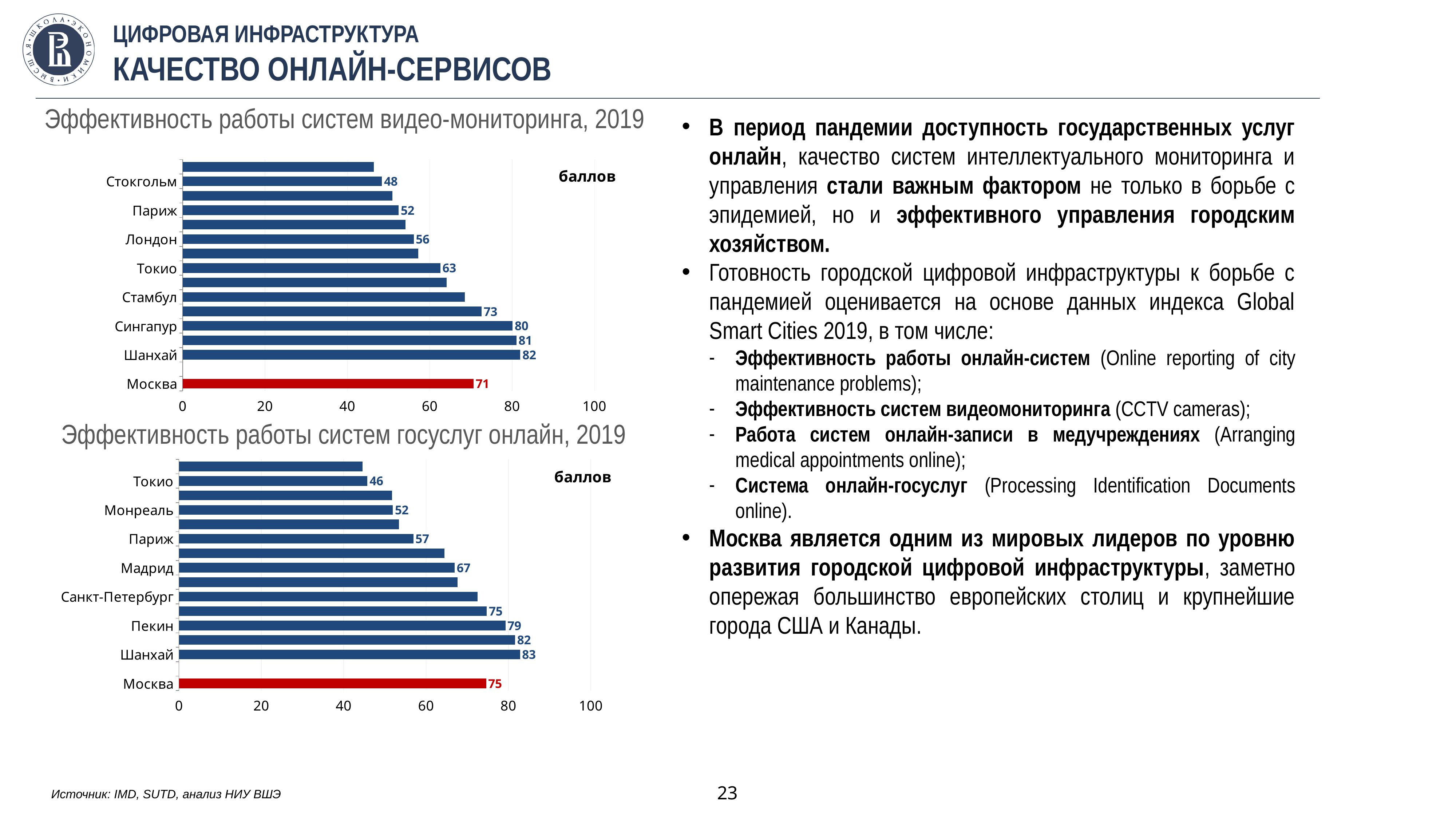
In the top chart (Эффективность работы систем видео-мониторинга, 2019), what is the difference between Шанхай and Москва? 11 In the top chart (Эффективность работы систем видео-мониторинга, 2019), what is the value for Стокгольм? 48 In the top chart (Эффективность работы систем видео-мониторинга, 2019), which is larger, the value for Лондон or the value for Токио? Токио In the bottom chart (Эффективность работы систем госуслуг онлайн, 2019), what is the value for Пекин? 79 In the bottom chart (Эффективность работы систем госуслуг онлайн, 2019), what is the difference between Шанхай and Москва? 8 In the bottom chart (Эффективность работы систем госуслуг онлайн, 2019), what is the value for Токио? 46 In the top chart (Эффективность работы систем видео-мониторинга, 2019), which city's bar is coloured red? Москва In the bottom chart (Эффективность работы систем госуслуг онлайн, 2019), what is the value for Москва? 75 In the top chart (Эффективность работы систем видео-мониторинга, 2019), which labelled city has the highest value? Шанхай What kind of chart is the bottom chart (Эффективность работы систем госуслуг онлайн, 2019)? Bar chart In the top chart (Эффективность работы систем видео-мониторинга, 2019), what is the value for Сингапур? 80 In the top chart (Эффективность работы систем видео-мониторинга, 2019), what is the value for Москва? 71